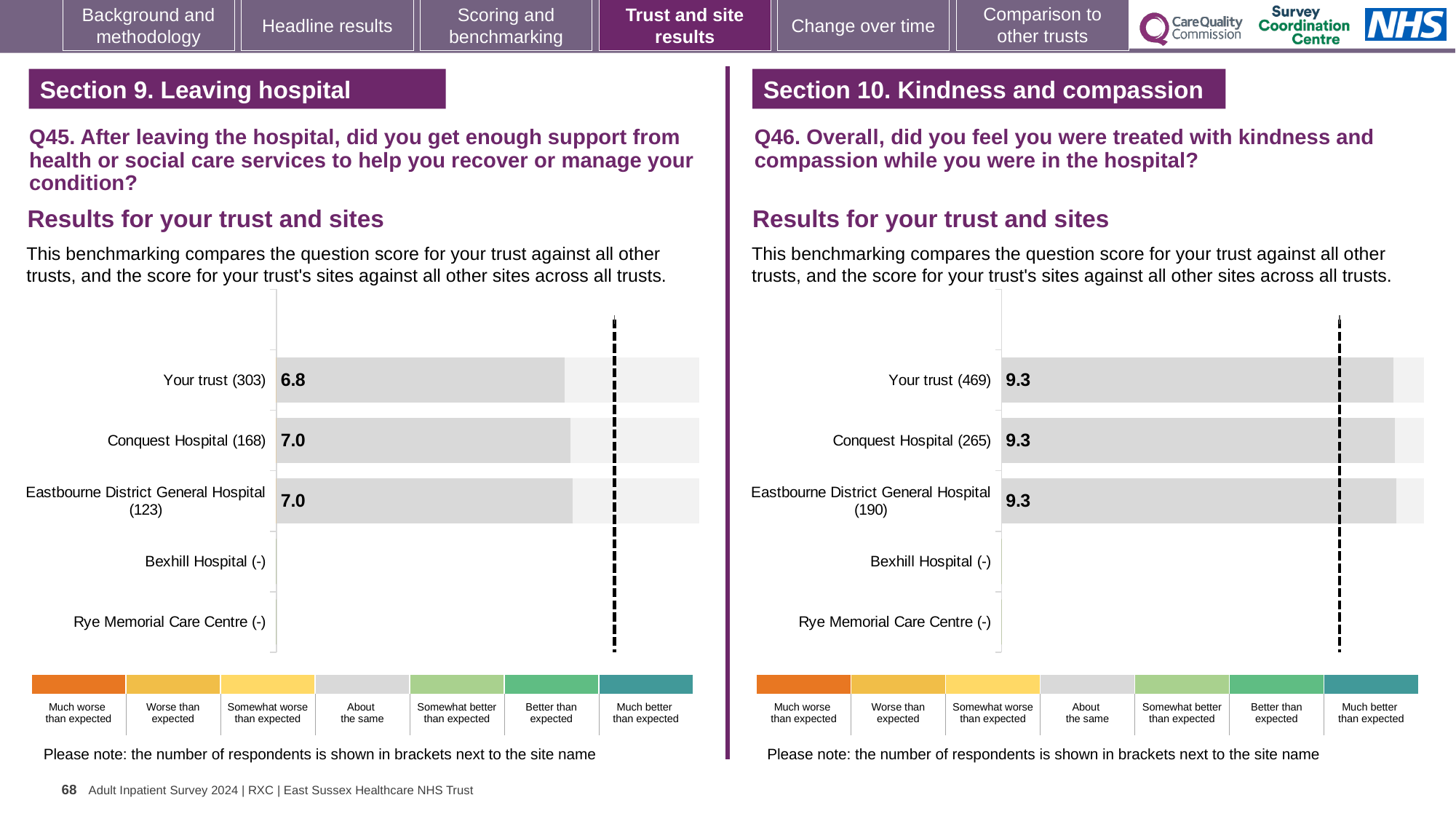
In the Q45 chart on the left, how many respondents are shown for Conquest Hospital? 168 In the Q46 chart on the right, how many rows show a plotted score? 3 What kind of chart is used for the Q46 results on the right? Bar chart In the Q45 chart on the left, what is the score for Conquest Hospital (168)? 7.0 In the Q45 chart on the left, which is larger: the score for Conquest Hospital or the score for Your trust? Conquest Hospital In the Q45 chart on the left, which row has the lowest score? Your trust (303) In the Q45 chart on the left, what is the score for Your trust (303)? 6.8 In the Q45 chart on the left, what is the difference between the Conquest Hospital score and the Your trust score? 0.2 In the Q46 chart on the right, what is the score for Eastbourne District General Hospital (190)? 9.3 How many site or trust rows are listed in the Q45 chart on the left? 5 In the Q45 chart on the left, what is the score for Eastbourne District General Hospital (123)? 7.0 In the Q46 chart on the right, what is the score for Your trust (469)? 9.3